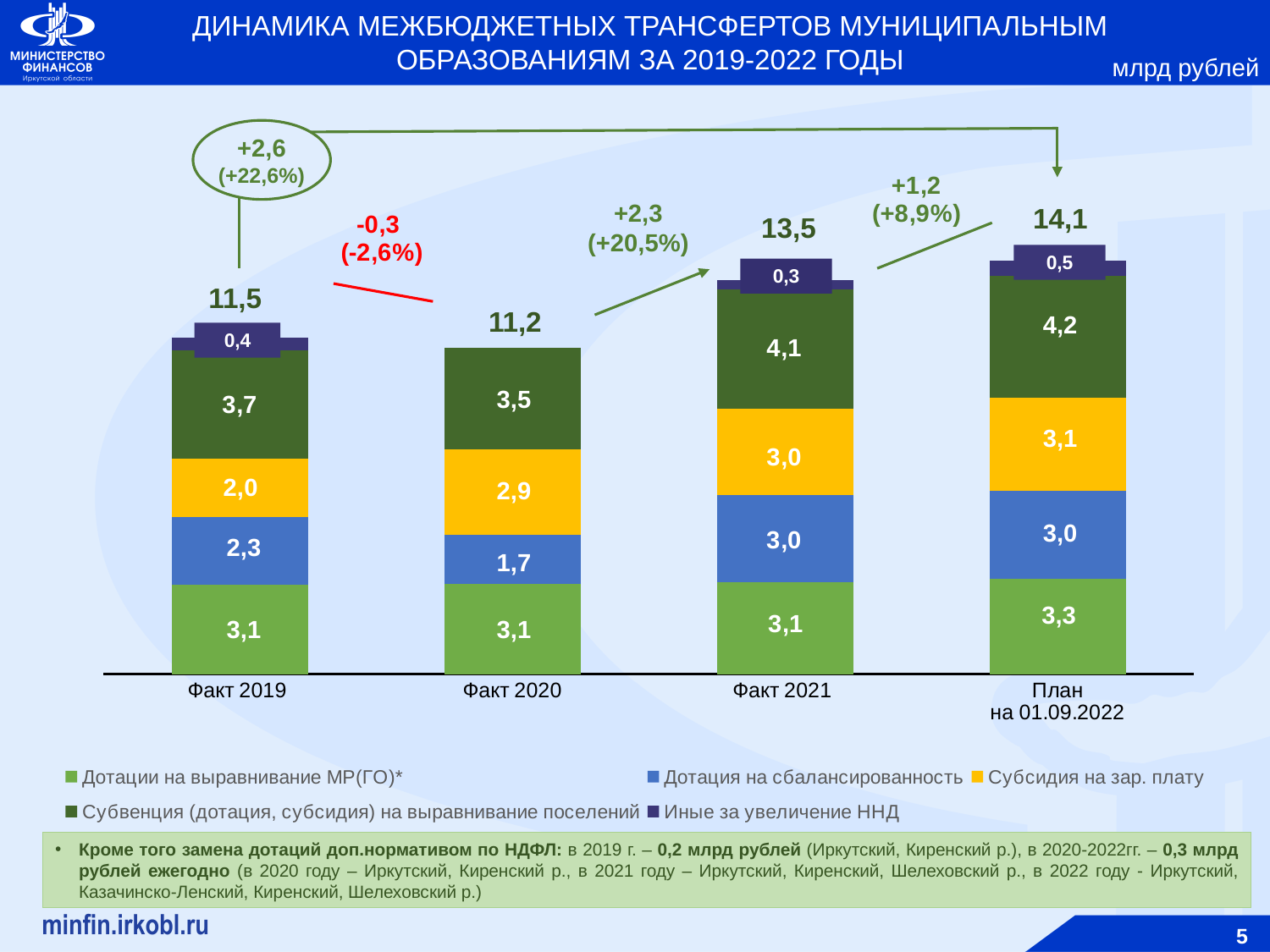
What unit of measurement is indicated for the chart values? млрд рублей What type of chart is shown on the slide? Stacked bar chart What is the difference between the Субсидия на зар. плату values for Факт 2020 and Факт 2019? 0,9 How many series does the chart legend list? 5 What is the value of Дотация на сбалансированность for Факт 2020? 1,7 What is the total value of the bar for Факт 2021? 13,5 How many categories are shown along the x axis of the chart? 4 What is the value of Субвенция (дотация, субсидия) на выравнивание поселений for План на 01.09.2022? 4,2 Which is larger: Дотации на выравнивание МР(ГО)* for План на 01.09.2022 or for Факт 2021? План на 01.09.2022 Which category has the highest total value? План на 01.09.2022 What is the value of Иные за увеличение ННД for Факт 2019? 0,4 Which category has the lowest total value? Факт 2020